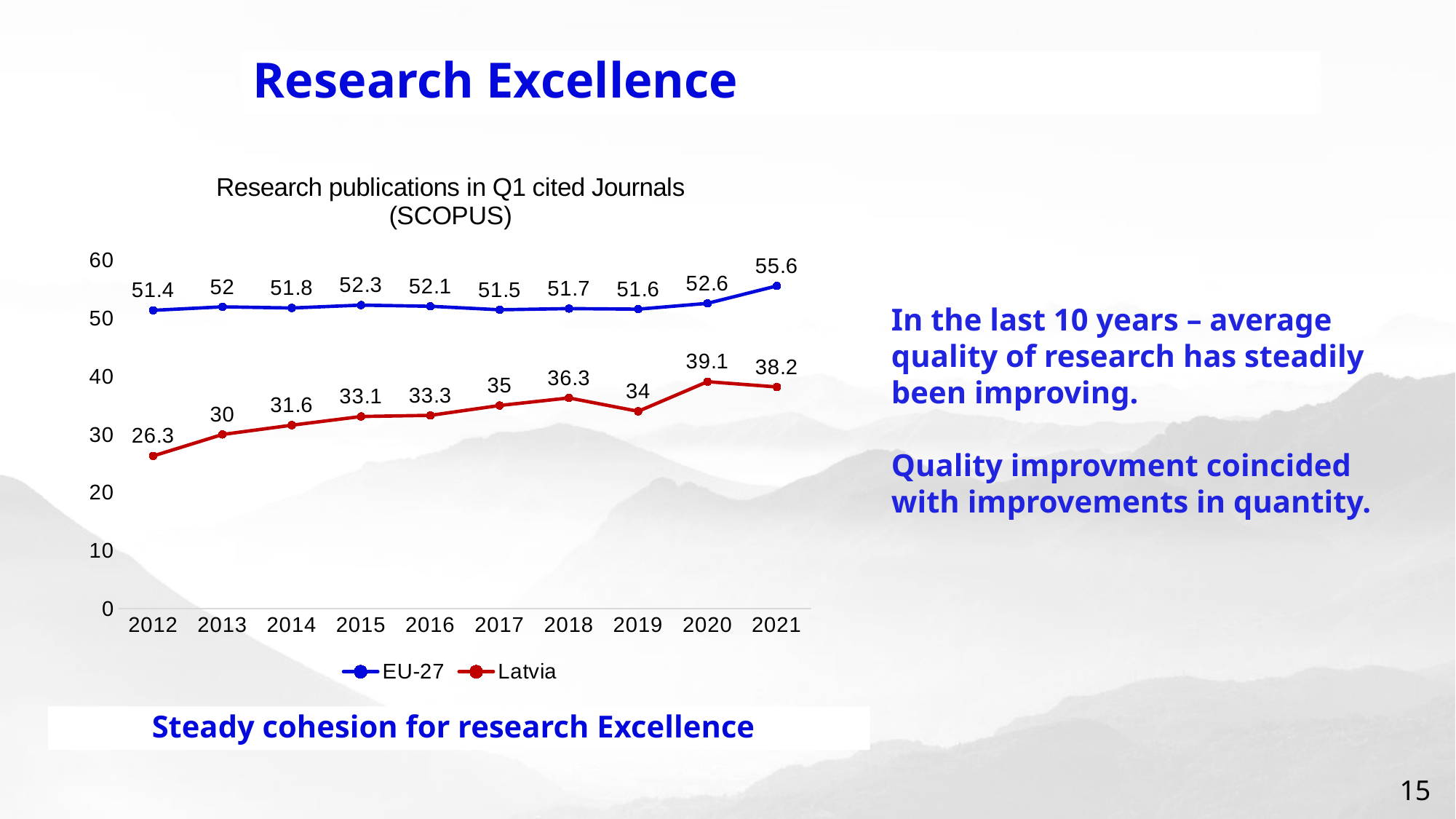
In which year is the Latvia series lowest? 2012 What is the value for Latvia in 2012? 26.3 How many years are shown on the x axis? 10 What is the value for Latvia in 2020? 39.1 What is the title of the chart? Research publications in Q1 cited Journals (SCOPUS) In which year is the Latvia series highest? 2020 In which year is the EU-27 series highest? 2021 How many series does the legend list? 2 Which series has the larger value in 2016, EU-27 or Latvia? EU-27 What is the difference between the EU-27 and Latvia values in 2021? 17.4 What is the value for EU-27 in 2021? 55.6 What kind of chart is shown on the slide? Line chart